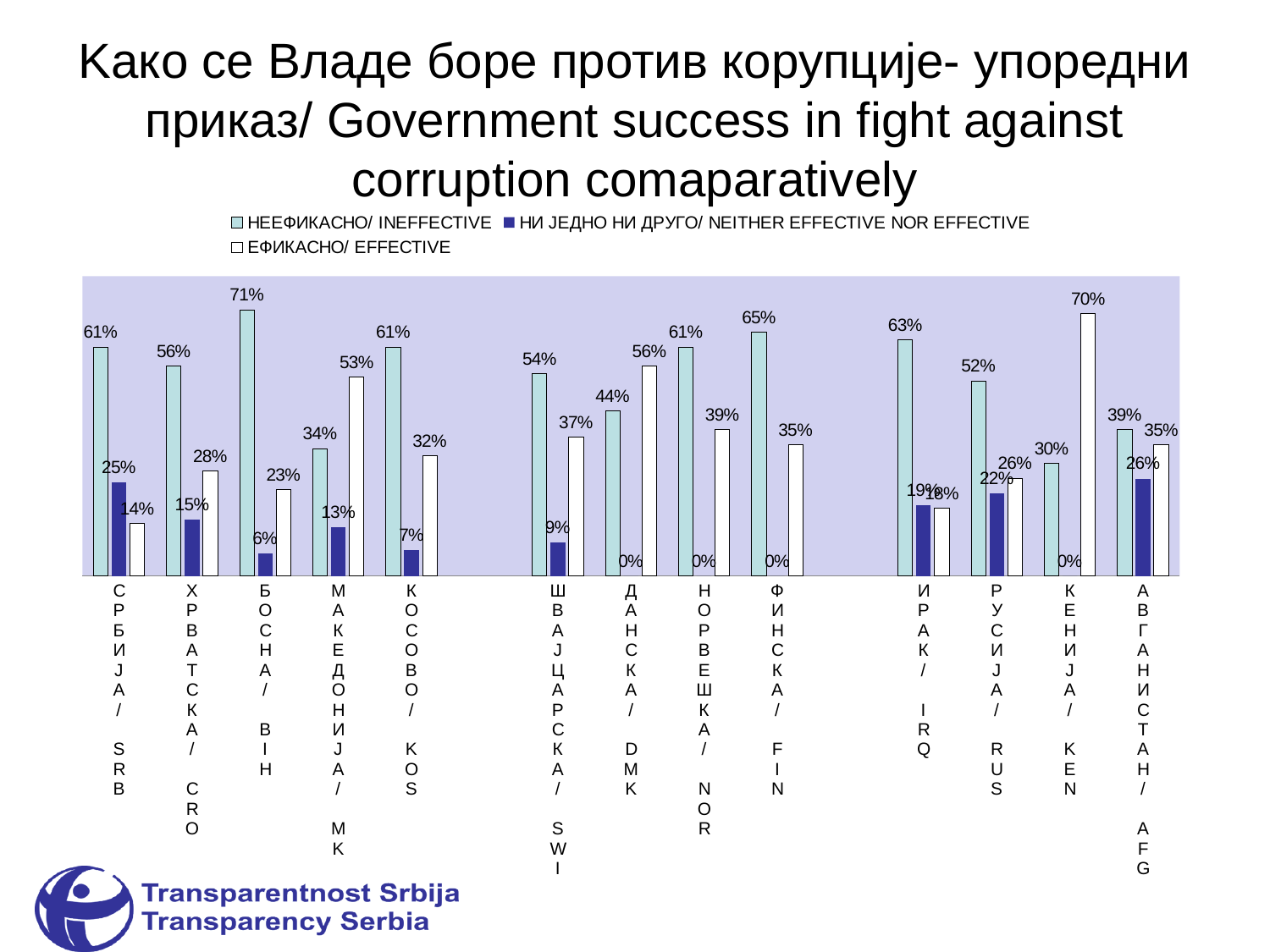
How many countries are shown on the x axis? 13 How many series does the legend list? 3 What kind of chart is shown on the slide? bar chart Which is larger for ДАНСКА/DMK: the INEFFECTIVE value or the EFFECTIVE value? EFFECTIVE Which country has the highest EFFECTIVE value? КЕНИЈА/KEN Which country has the lowest INEFFECTIVE value? КЕНИЈА/KEN What is the EFFECTIVE value for МАКЕДОНИЈА/MK? 53% What is the NEITHER EFFECTIVE NOR EFFECTIVE value for РУСИЈА/RUS? 22% What is the INEFFECTIVE value for СРБИЈА/SRB? 61% Which country has the highest INEFFECTIVE value? БОСНА/BIH Which series is drawn with white bars? ЕФИКАСНО/ EFFECTIVE What is the difference between the INEFFECTIVE and EFFECTIVE values for ХРВАТСКА/CRO? 28%